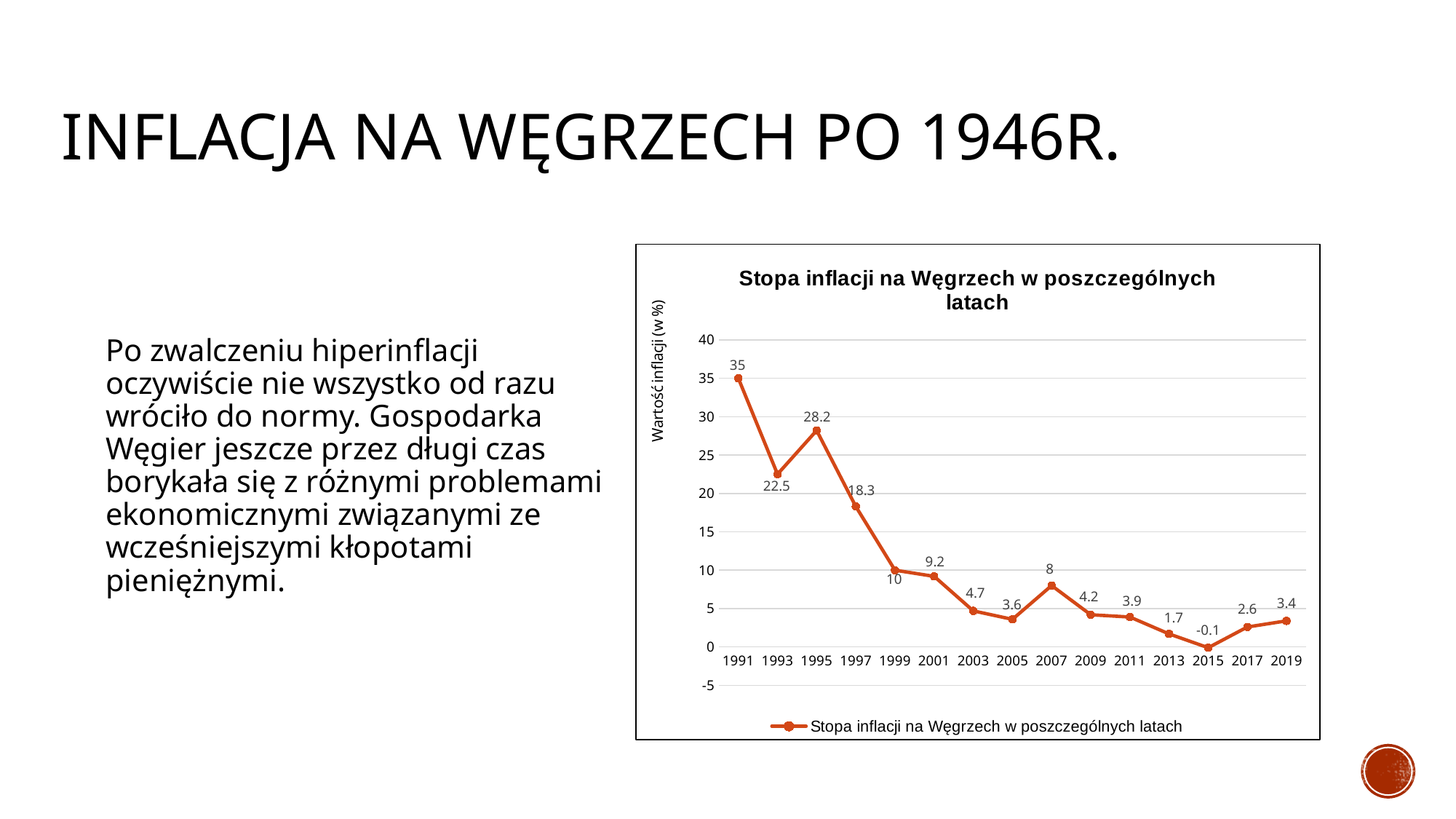
What is the inflation rate shown for 1995? 28.2 What is the inflation rate shown for 1991? 35 What is the inflation rate shown for 2015? -0.1 Which year has the lowest inflation rate? 2015 What is the title of the chart? Stopa inflacji na Węgrzech w poszczególnych latach Which year has a higher inflation rate, 1997 or 1999? 1997 What kind of chart is shown? Line chart What is the difference between the inflation rates for 1991 and 1993? 12.5 How many series does the legend list? 1 How many years are plotted on the chart? 15 Which year has the highest inflation rate? 1991 What is the inflation rate shown for 2007? 8